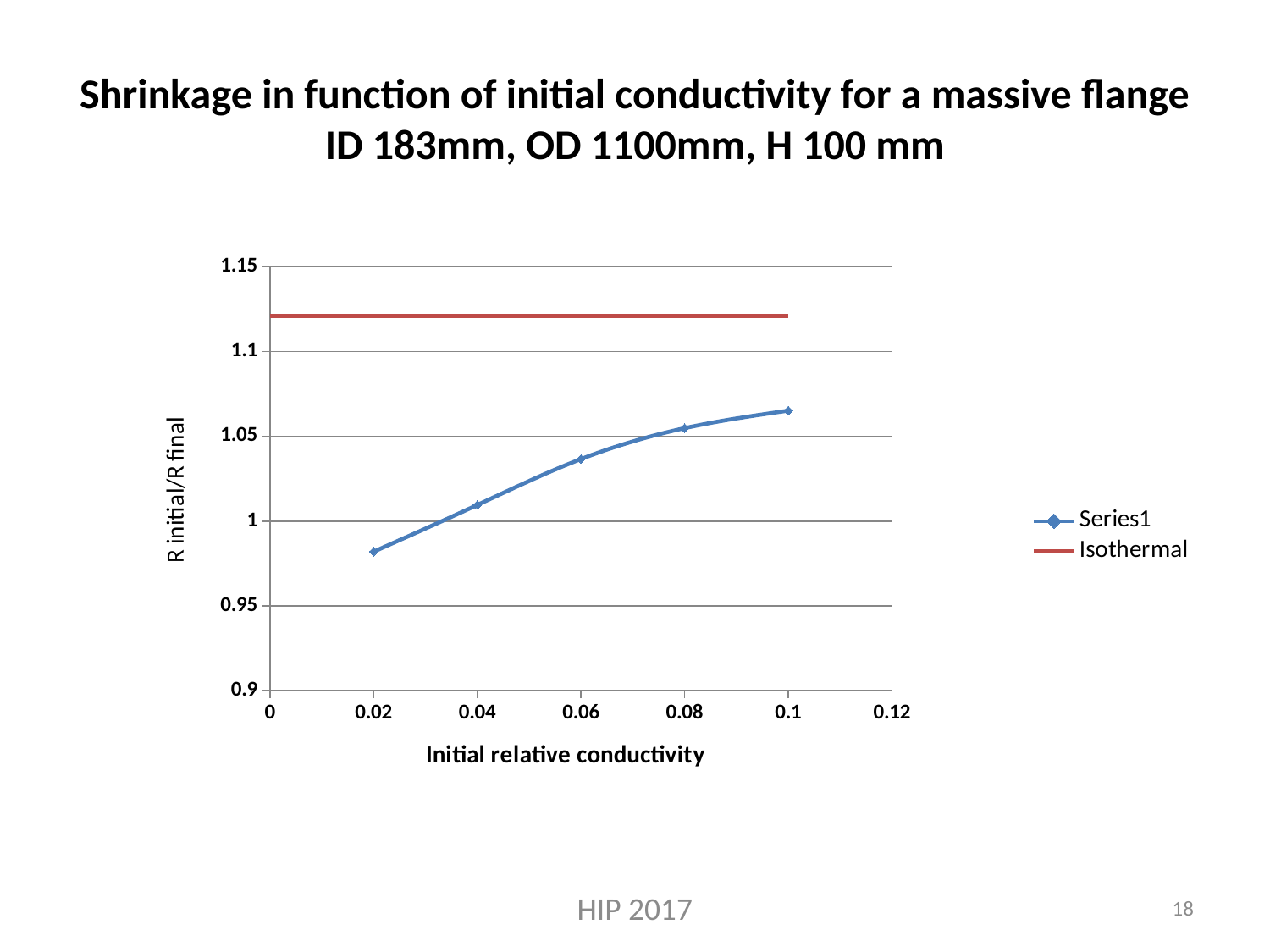
What is the title of the x axis? Initial relative conductivity How many series does the legend list? 2 Does the Series1 line rise or fall as initial relative conductivity increases? rises Is the Series1 value at an initial relative conductivity of 0.06 greater or less than 1.05? less Is the Series1 value at an initial relative conductivity of 0.02 greater or less than 1? less Is the Isothermal line greater or less than 1.1? greater What kind of chart is shown on the slide? line chart What is the title of the y axis? R initial/R final How many data points are plotted for Series1? 5 Which is larger at an initial relative conductivity of 0.1: the Isothermal value or the Series1 value? Isothermal